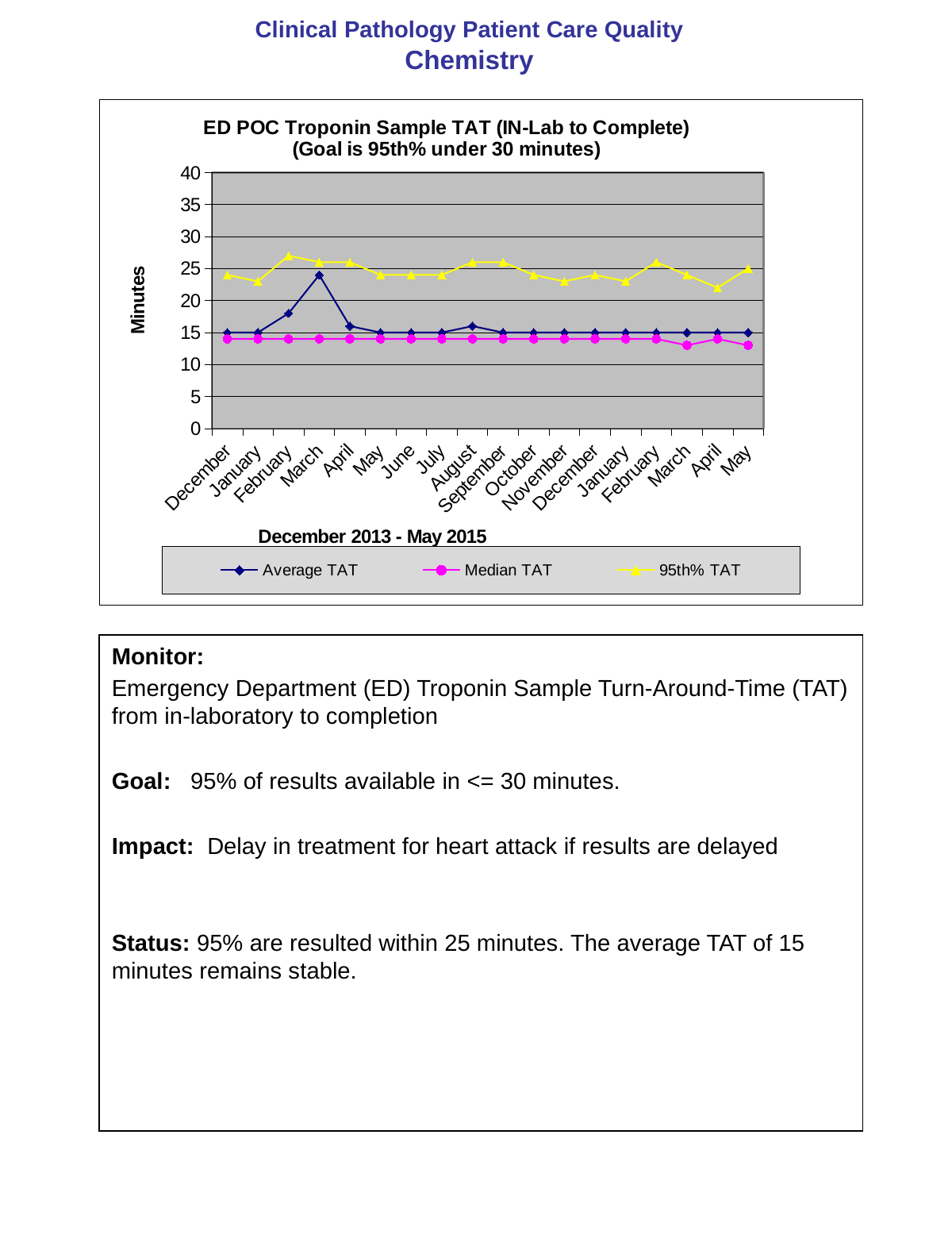
How many monthly data points are plotted along the x axis? 18 What goal is stated in the chart title? 95th% under 30 minutes Is the Median TAT for December 2013 greater or less than 20? less What kind of chart is shown on the slide? line chart Is the 95th% TAT for April 2015 greater or less than 25? less Is the 95th% TAT for February 2014 greater or less than 25? greater Which is larger, the Average TAT in March 2014 or the Average TAT in April 2014? March 2014 Which series has the highest values throughout the chart? 95th% TAT How many series does the legend list? 3 What is the label on the y axis? Minutes In which month does the Average TAT reach its highest value? March (2014)